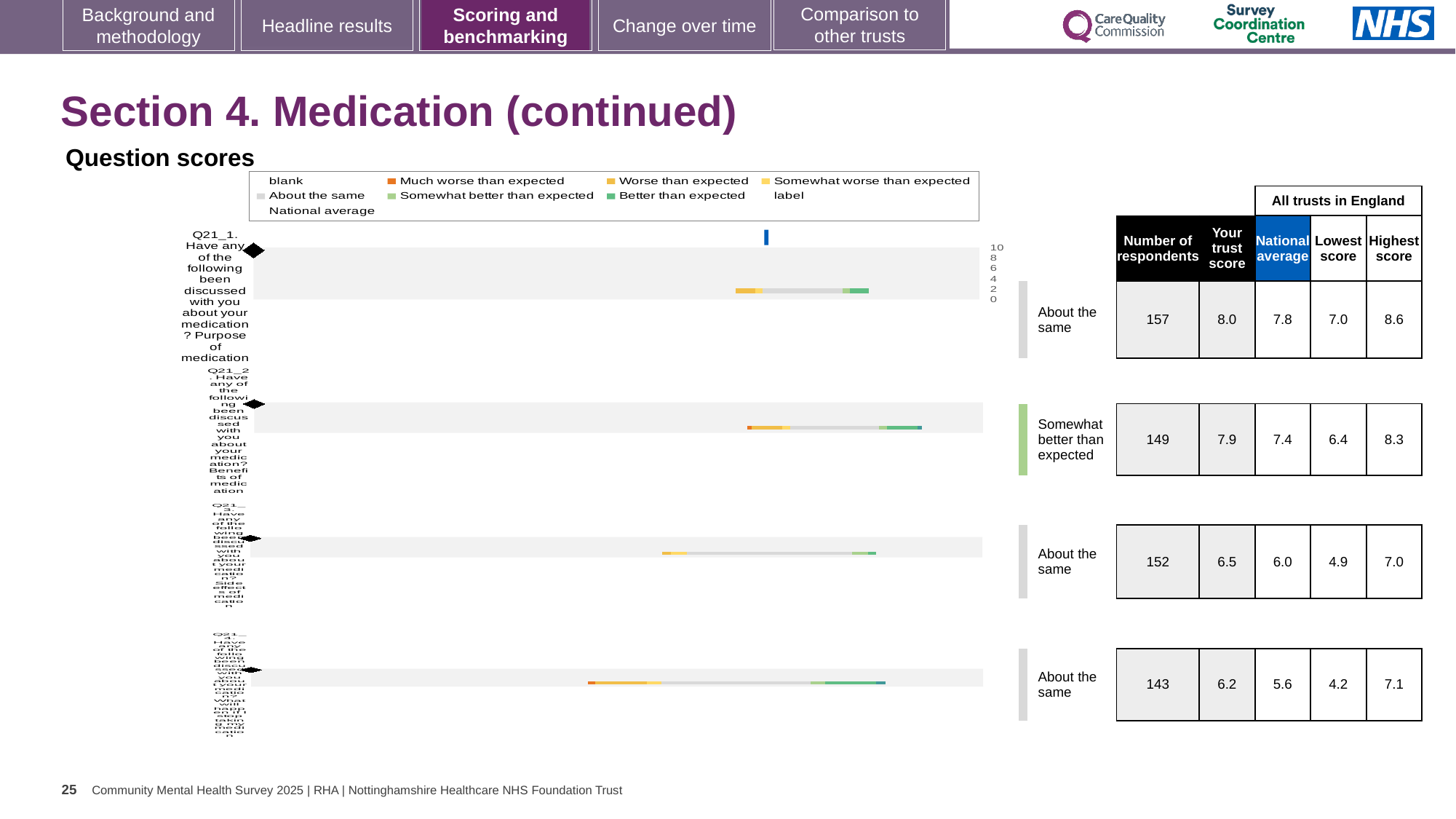
Which legend entry in the Question scores chart is shown in dark orange? Much worse than expected Which question has the lowest trust score? Q21_4 What kind of chart is shown under "Question scores"? bar chart Which question has the highest trust score? Q21_1 What is the highest tick value shown on the axis of the Question scores chart? 10 What is the trust score for Q21_1 (Purpose of medication)? 8.0 What is the number of respondents for Q21_3 (Side effects of medication)? 152 What is the national average for Q21_2 (Benefits of medication)? 7.4 Which question is rated "Somewhat better than expected"? Q21_2 How many entries does the legend of the Question scores chart list? 9 How many questions (bars) are plotted in the Question scores chart? 4 What is the difference between the trust score and the national average for Q21_4? 0.6